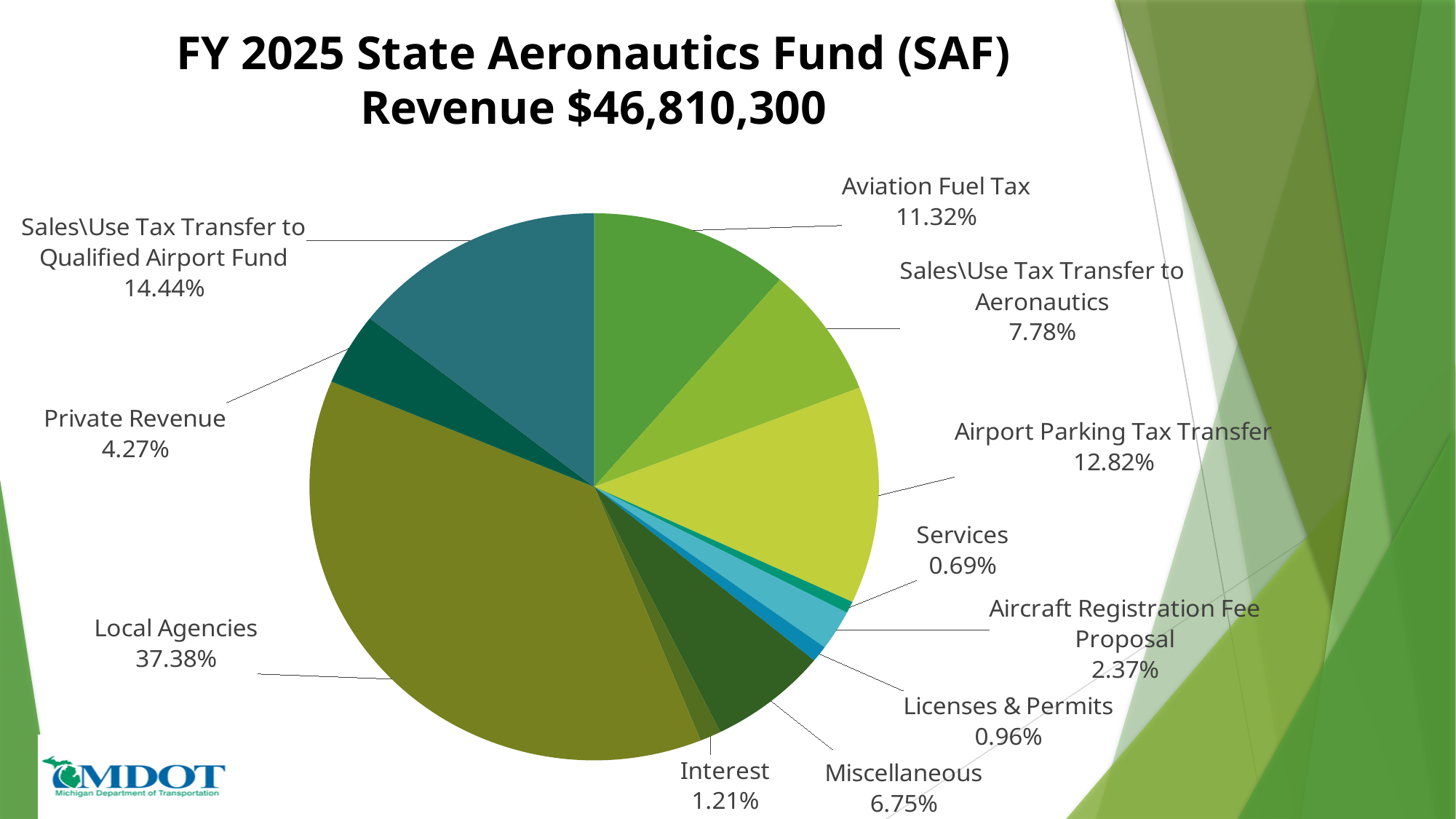
Which revenue source has the largest share of the pie? Local Agencies Which is larger: Miscellaneous or Private Revenue? Miscellaneous Which revenue source has the smallest share of the pie? Services What total revenue amount is stated in the chart title? $46,810,300 What is the share for Airport Parking Tax Transfer? 12.82% What percentage does the Sales\Use Tax Transfer to Qualified Airport Fund represent? 14.44% What is the difference in percentage points between Airport Parking Tax Transfer and Aviation Fuel Tax? 1.50% What percentage of revenue is attributed to Aviation Fuel Tax? 11.32% How many revenue categories are shown in the pie chart? 11 What type of chart is shown on the slide? Pie chart What share of FY 2025 SAF revenue comes from Local Agencies? 37.38% What is the difference between the Local Agencies share and the Sales\Use Tax Transfer to Qualified Airport Fund share? 22.94%